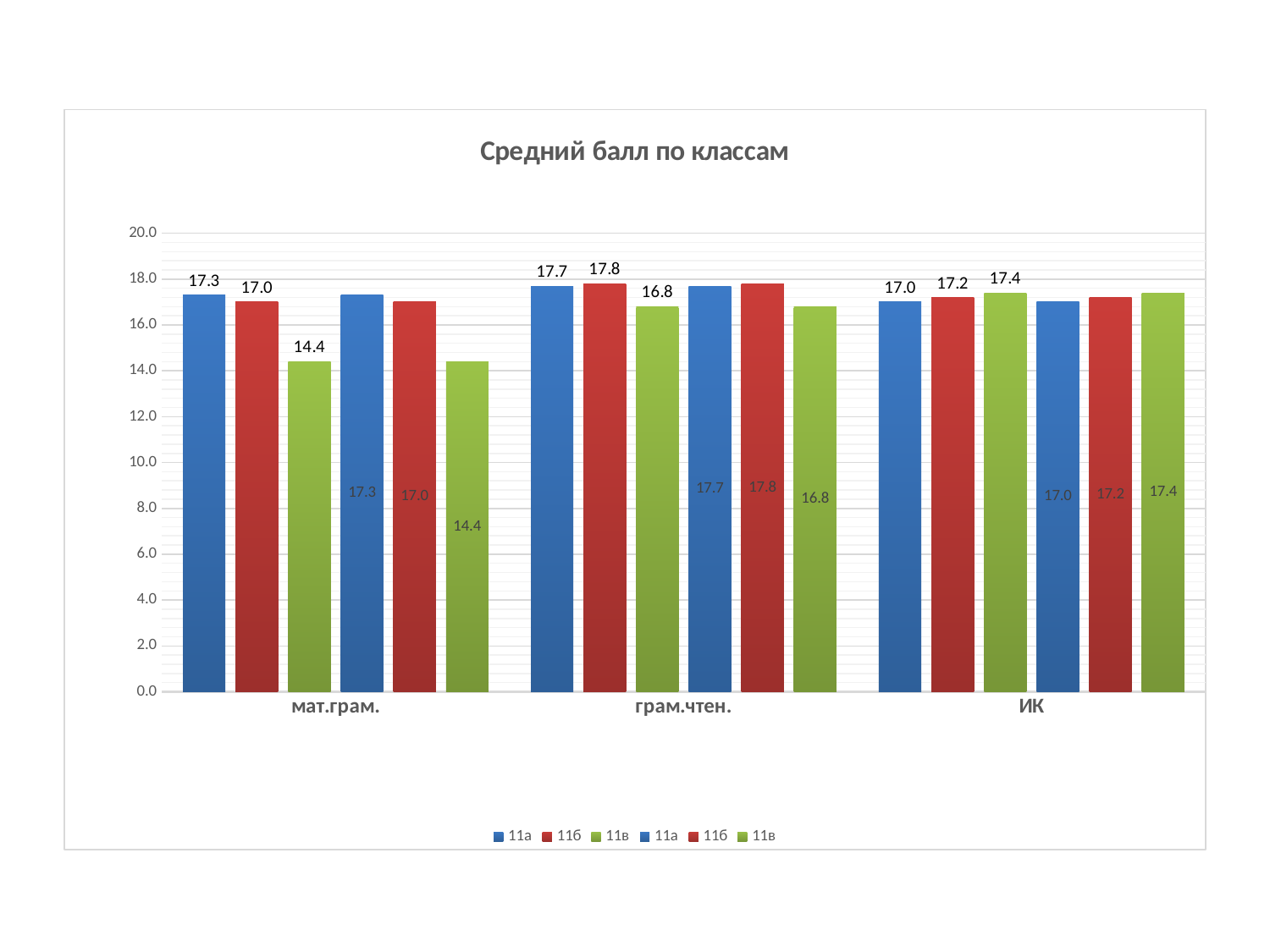
Which is larger in the грам.чтен. category: the value for 11а or the value for 11в? 11а What is the title of the chart? Средний балл по классам How many categories are shown on the x axis? 3 What is the difference between the 11а and 11в values in the мат.грам. category? 2.9 What kind of chart is shown on the slide? bar chart Is the value for 11в in the мат.грам. category greater or less than 16.0? less What is the value for 11а in the ИК category? 17.0 Which class has the highest value in the ИК category? 11в Which class has the lowest value in the мат.грам. category? 11в What is the value for 11в in the мат.грам. category? 14.4 What is the value for 11б in the грам.чтен. category? 17.8 How many entries does the legend list? 6